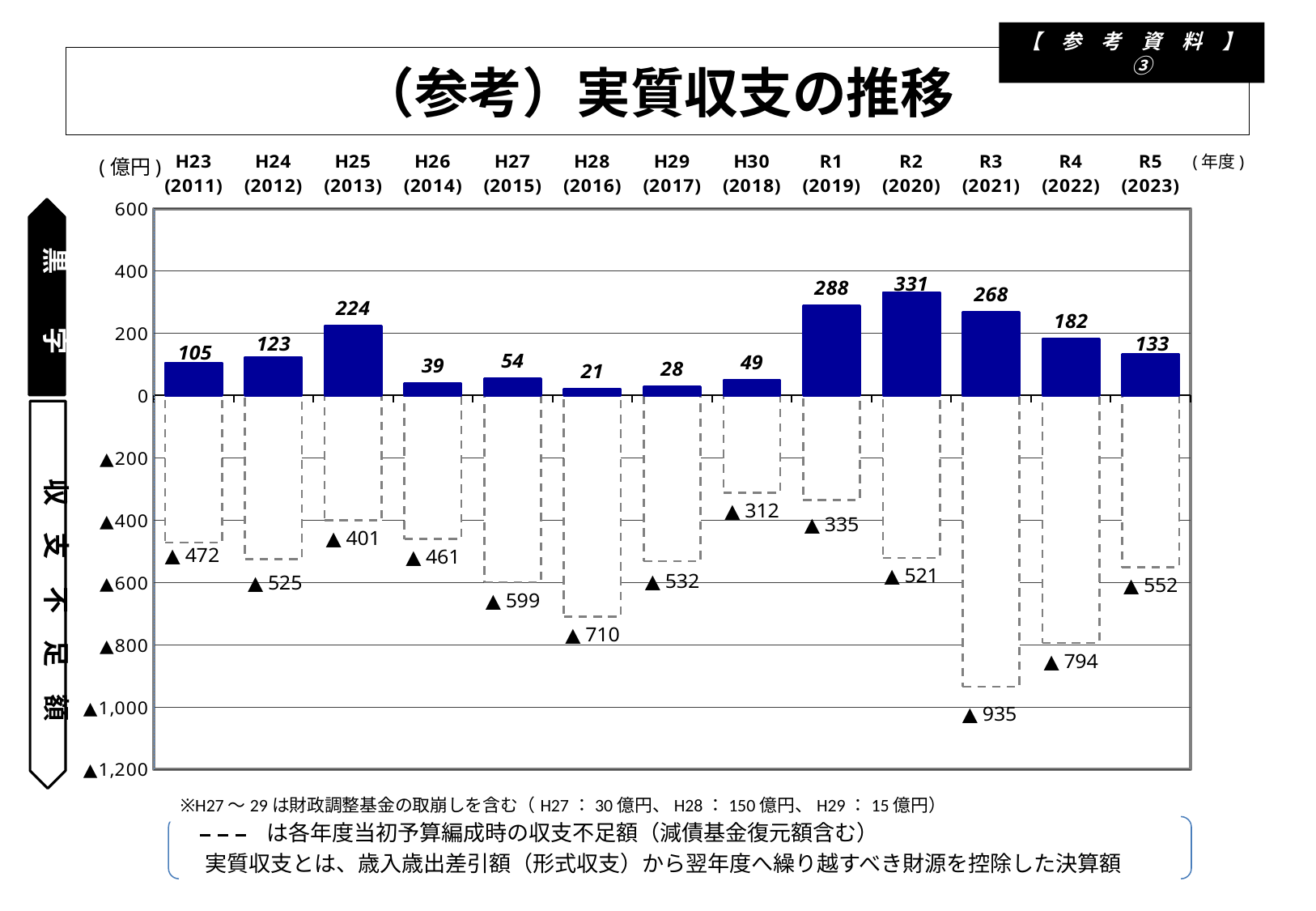
Which fiscal year has the largest budget shortfall (収支不足額)? R3 (2021) What unit is shown for the vertical axis? 億円 What is the difference between the surplus values for R1 (2019) and R5 (2023)? 155 What is the surplus value shown for H28 (2016)? 21 Which has the larger surplus value, H25 (2013) or R4 (2022)? H25 (2013) What is the budget shortfall value shown for H30 (2018)? ▲312 How many fiscal years are shown on the x axis? 13 What kind of chart is shown on the slide? Bar chart Which fiscal year has the lowest surplus bar? H28 (2016) Which fiscal year has the highest surplus bar? R2 (2020) What is the surplus (黒字) value shown for R2 (2020)? 331 What is the budget shortfall (収支不足額) value shown for R3 (2021)? ▲935